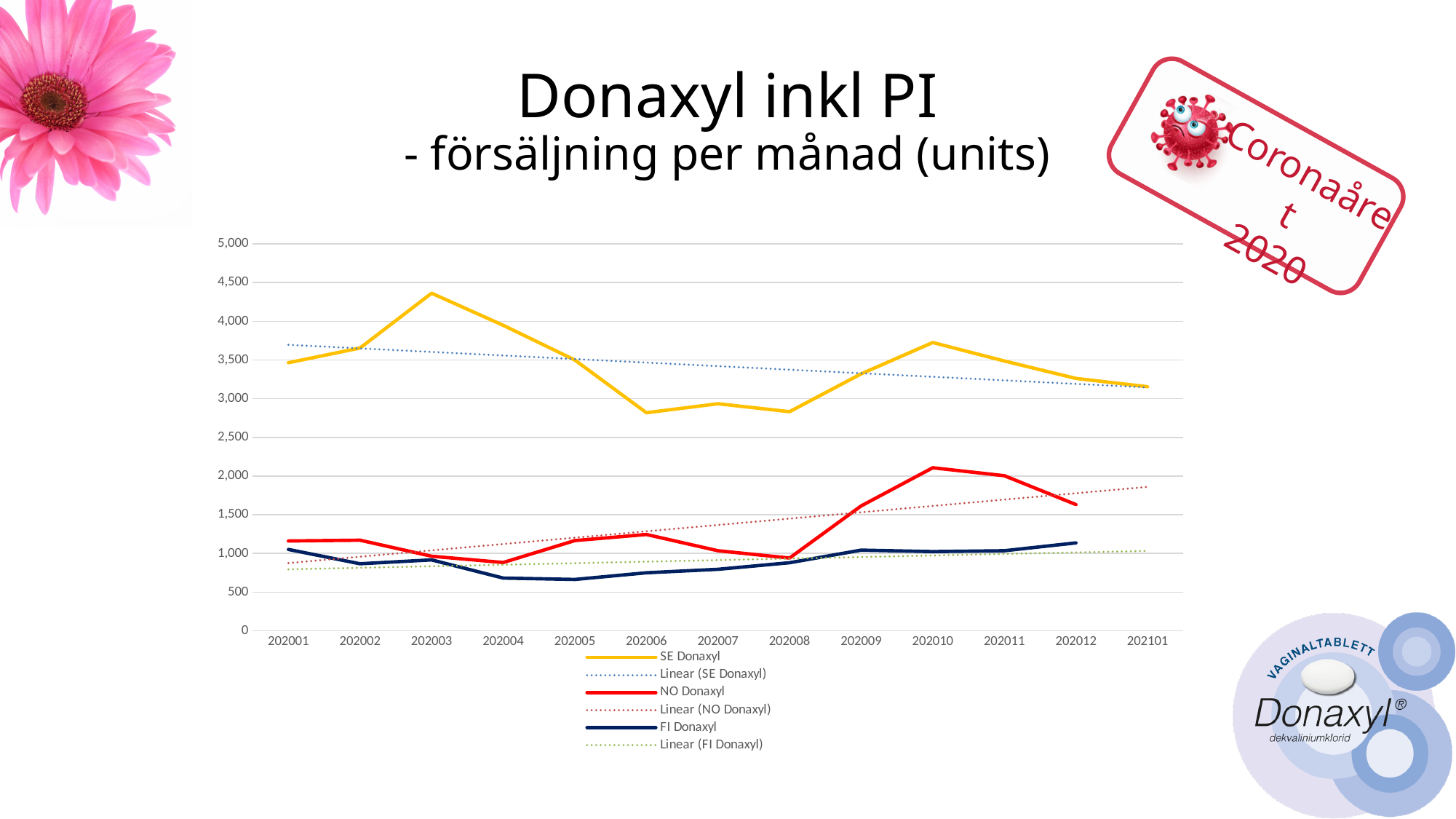
How many months (x-axis points) are plotted on the chart? 13 Is the value for SE Donaxyl in 202006 greater or less than 3,000? less In which month does SE Donaxyl reach its highest value? 202003 What kind of chart is shown on the slide? line chart Is the value for NO Donaxyl in 202010 greater or less than 2,000? greater Which is larger in 202001, SE Donaxyl or NO Donaxyl? SE Donaxyl In which month does NO Donaxyl reach its highest value? 202010 What is the title of the chart slide? Donaxyl inkl PI - försäljning per månad (units) Is the value for SE Donaxyl in 202003 greater or less than 4,000? greater How many entries does the chart legend list? 6 Does the Linear (NO Donaxyl) trendline rise or fall from 202001 to 202101? rise